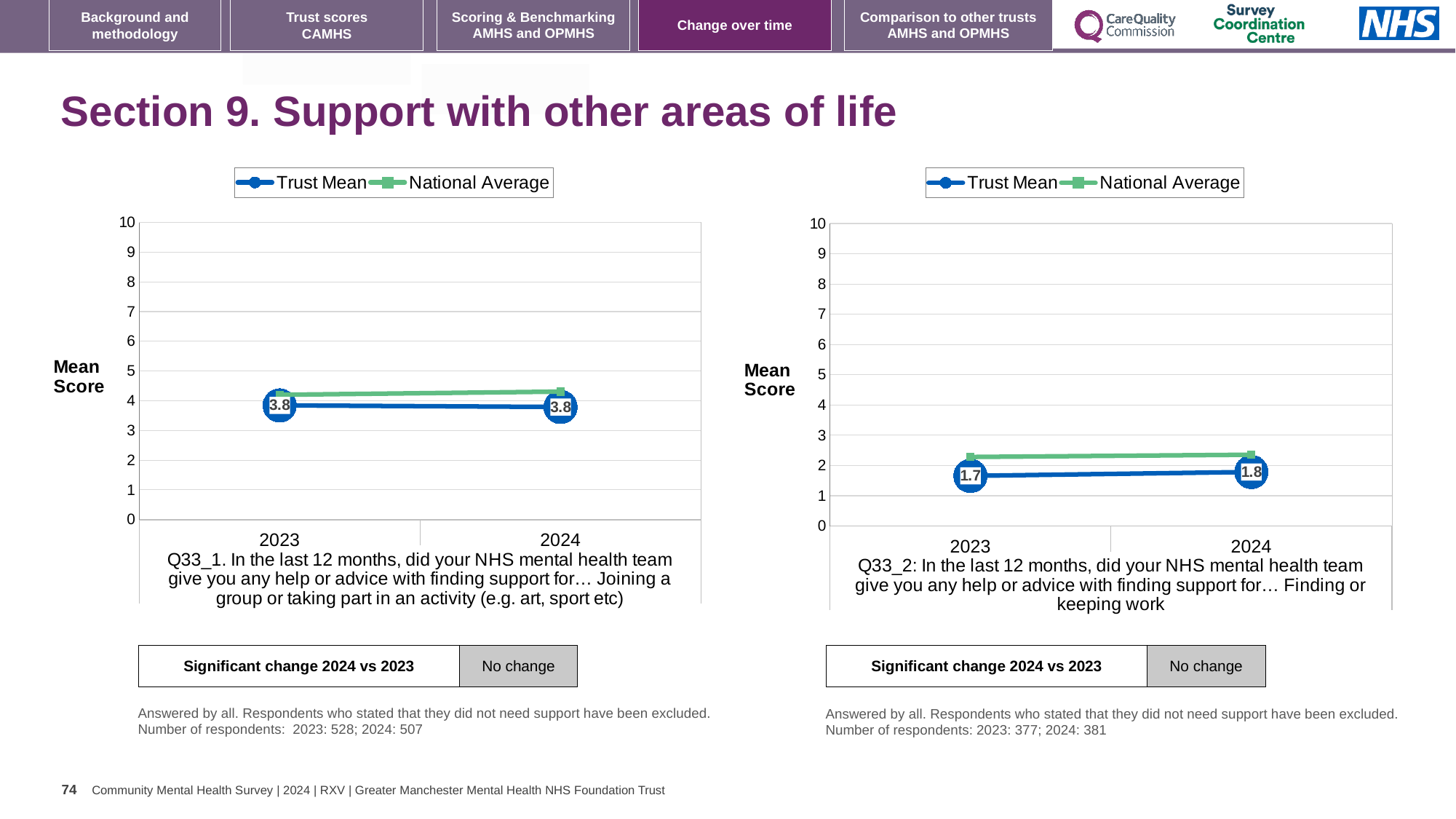
How many years are shown on the x axis of the left chart (Q33_1)? 2 How many series does the legend of the right chart (Q33_2) list? 2 On the right chart (Q33_2), by how much did the Trust Mean change from 2023 to 2024? 0.1 On the left chart (Q33_1), what is the Trust Mean score for 2024? 3.8 On the right chart (Q33_2), which is higher in 2024, the Trust Mean or the National Average? National Average On the right chart (Q33_2), does the Trust Mean rise or fall from 2023 to 2024? rise What type of chart is the left chart (Q33_1)? line chart On the right chart (Q33_2), what is the Trust Mean score for 2024? 1.8 On the left chart (Q33_1), is the National Average for 2024 greater or less than 5? less On the left chart (Q33_1), what is the Trust Mean score for 2023? 3.8 On the right chart (Q33_2), what is the Trust Mean score for 2023? 1.7 On the right chart (Q33_2), is the National Average for 2023 greater or less than 3? less